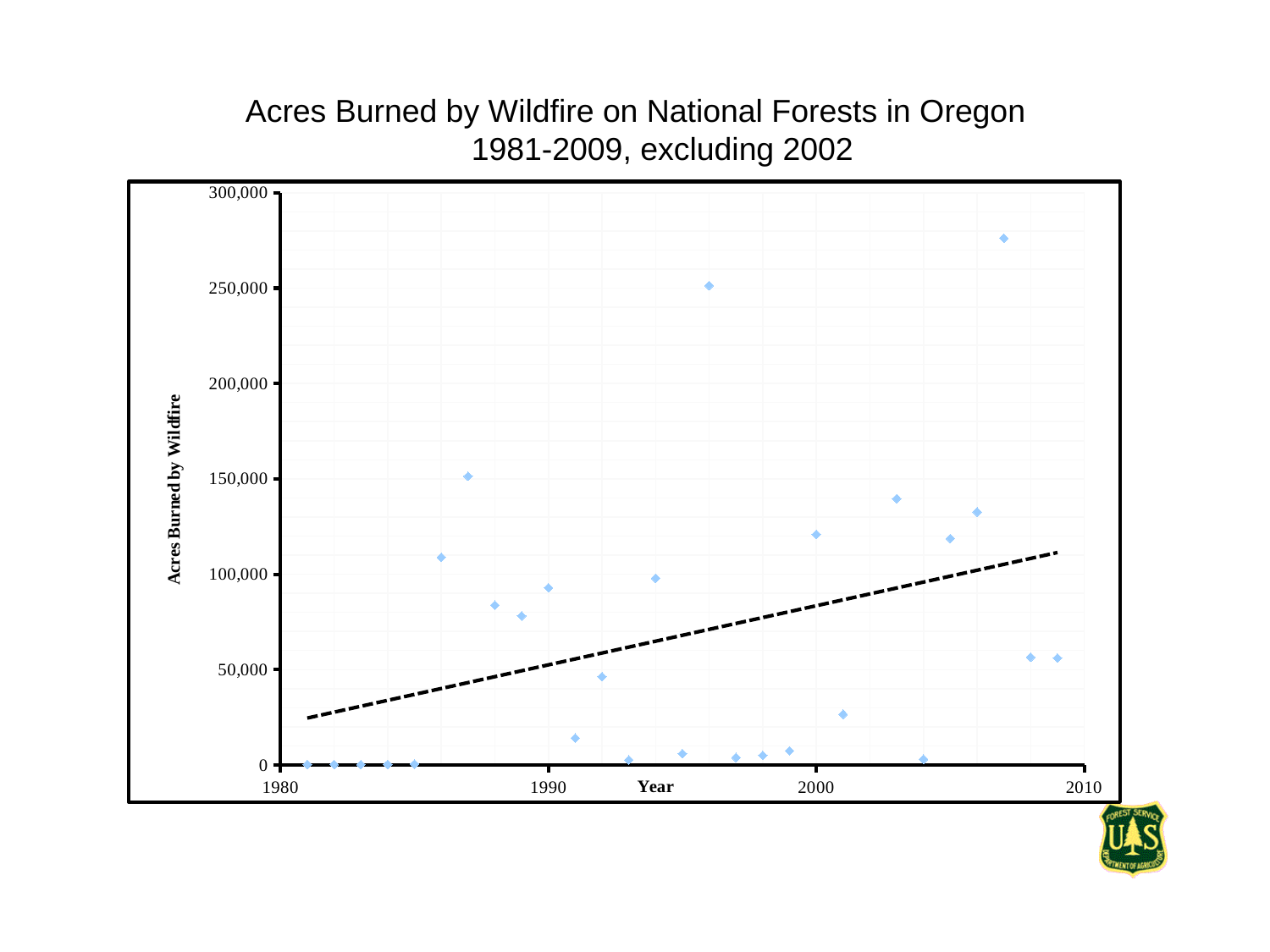
Which year has more acres burned, 1987 or 1986? 1987 What is the label of the y axis? Acres Burned by Wildfire Which year has the highest number of acres burned? 2007 Is the value for 1981 greater or less than 50,000? less Which year has more acres burned, 2007 or 1996? 2007 What is the title of the chart? Acres Burned by Wildfire on National Forests in Oregon 1981-2009, excluding 2002 Is the value for 1996 greater or less than 200,000? greater Is the value for 2000 greater or less than 100,000? greater Does the dashed trend line rise or fall from 1980 to 2010? rise What kind of chart is shown on the slide? scatter chart